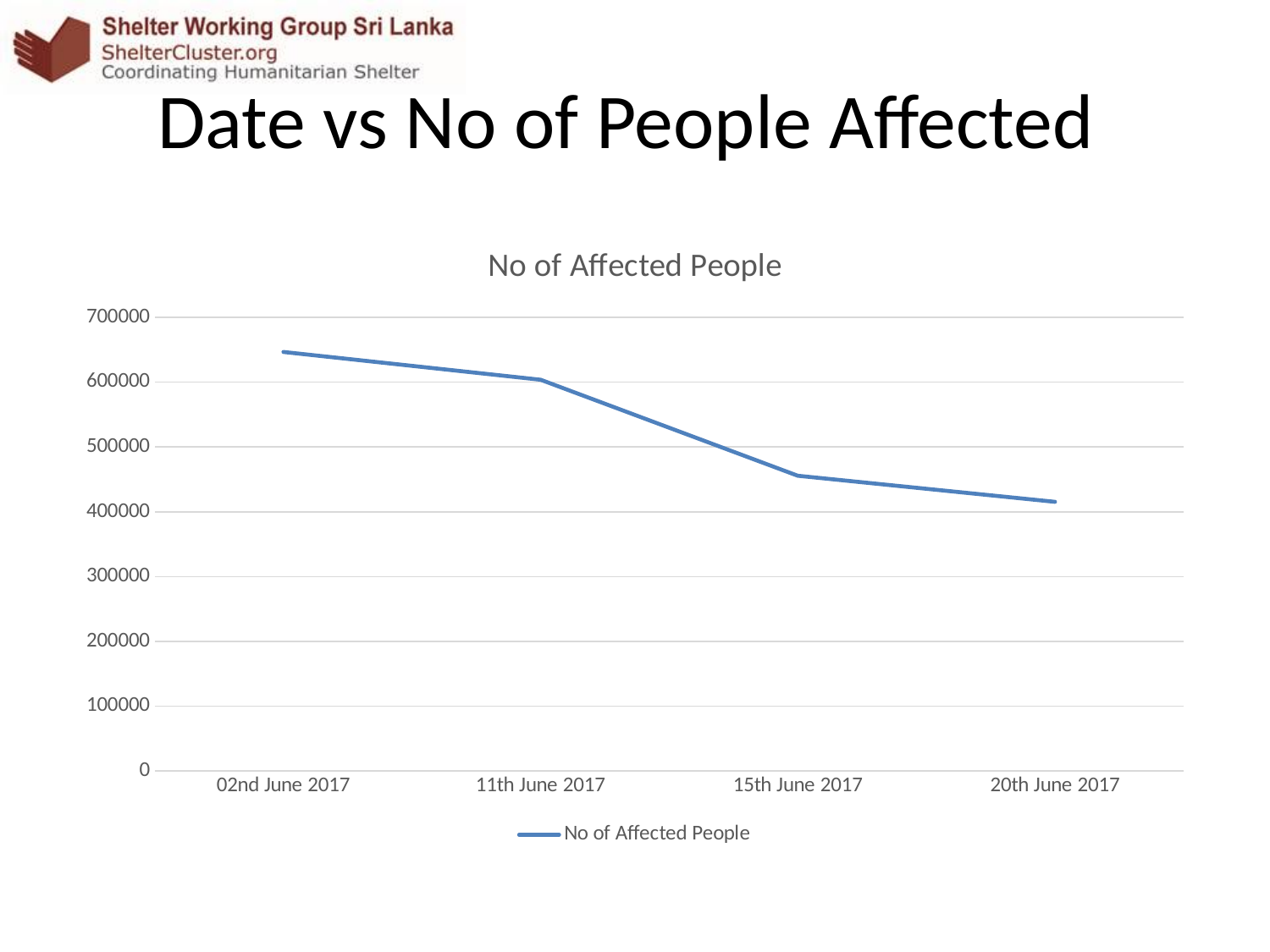
On which date is the number of affected people highest? 02nd June 2017 Is the value for 02nd June 2017 greater or less than 600000? greater Which is larger, the value for 11th June 2017 or the value for 15th June 2017? 11th June 2017 On which date is the number of affected people lowest? 20th June 2017 Is the value for 11th June 2017 greater or less than 500000? greater Is the value for 20th June 2017 greater or less than 500000? less How many series does the legend list? 1 What kind of chart is shown on the slide? line chart What is the title of the chart? No of Affected People Do the values rise or fall from 02nd June 2017 to 20th June 2017? fall How many dates are plotted on the x axis? 4